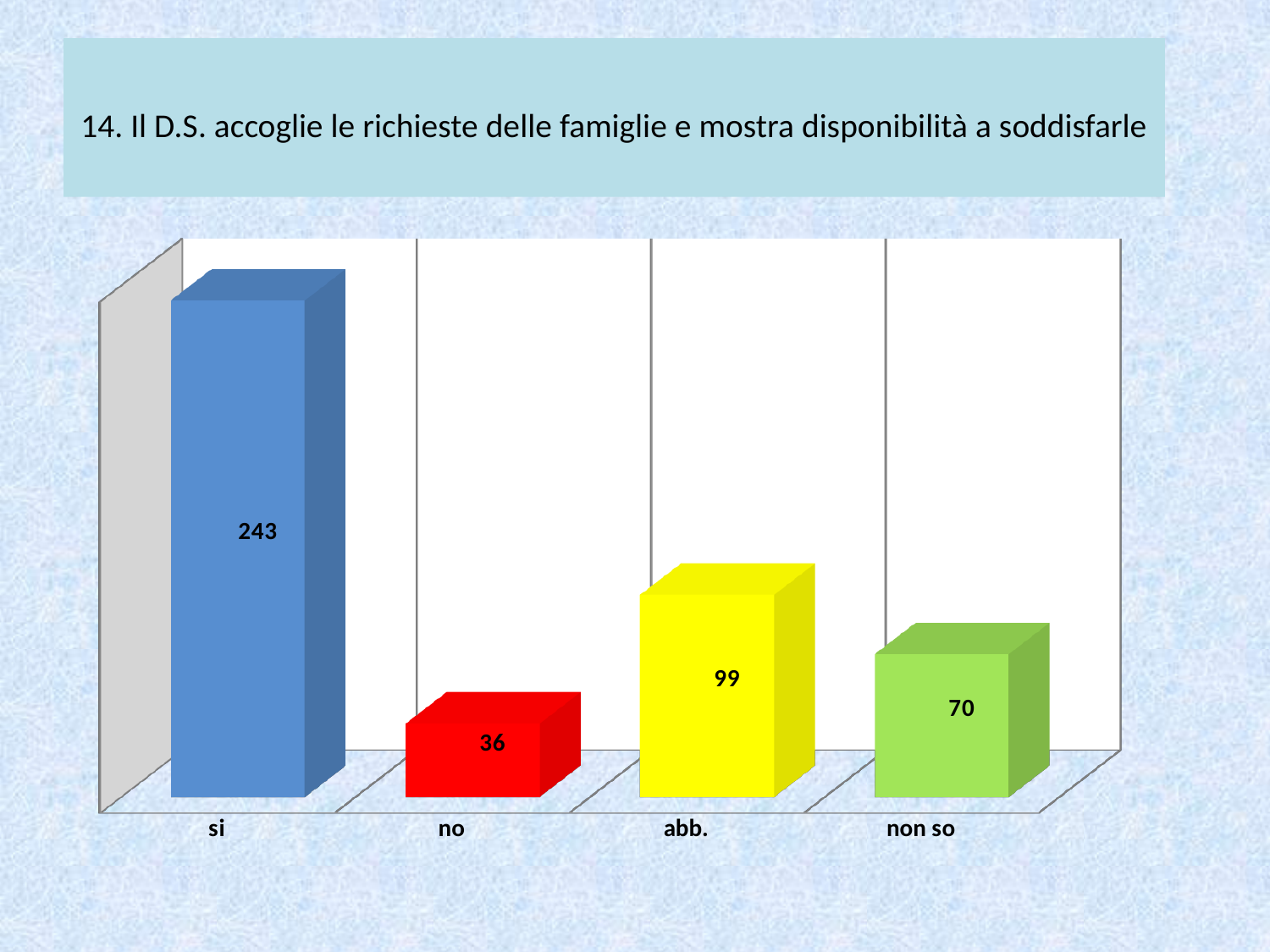
What colour is the bar for "abb."? yellow Which category has the highest value? si What is the difference between the values for "si" and "abb."? 144 What is the value for "si"? 243 What is the value for "no"? 36 Which is larger, the value for "non so" or the value for "no"? non so Which category has the lowest value? no How many categories are shown on the x axis? 4 What is the difference between the values for "abb." and "non so"? 29 What kind of chart is shown on the slide? bar chart What is the value for "non so"? 70 What is the value for "abb."? 99